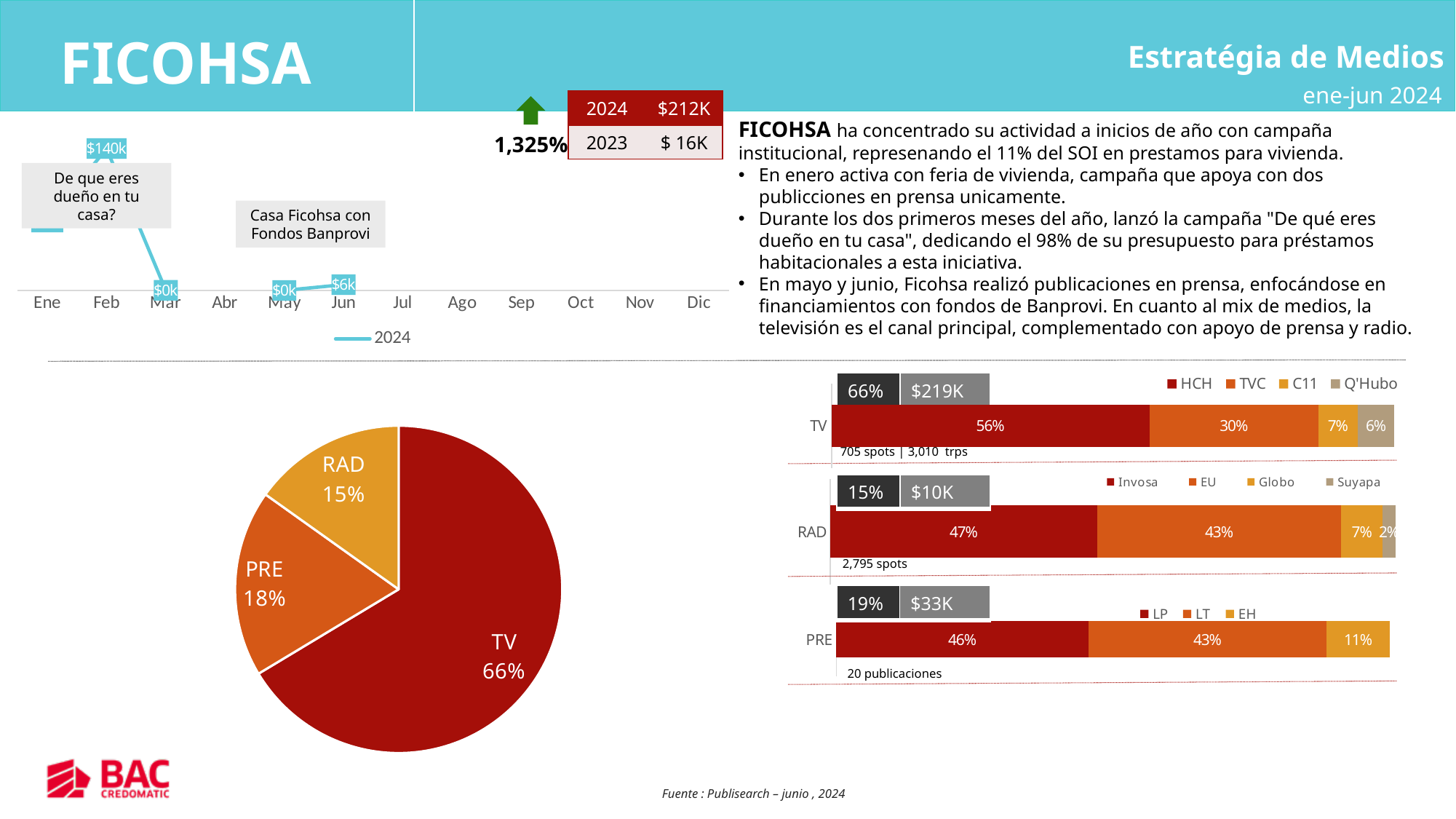
In the pie chart, which medium has the smallest slice? RAD In the RAD stacked bar chart, which is larger, Invosa or EU? Invosa In the PRE stacked bar chart, what percentage does EH represent? 11% How many slices does the pie chart have? 3 In the pie chart, what share of the media mix does TV account for? 66% How many series does the legend of the RAD stacked bar chart list? 4 In the monthly line chart at the top left, what is the value for Feb? $140k In the TV stacked bar chart, what percentage does HCH represent? 56% In the pie chart, what is the difference in percentage points between PRE and RAD? 3 In the PRE stacked bar chart, what is the difference in percentage points between LP and LT? 3 In the TV stacked bar chart, which channel has the lowest share? Q'Hubo What type of chart is used at the top left of the slide to show monthly spend? Line chart